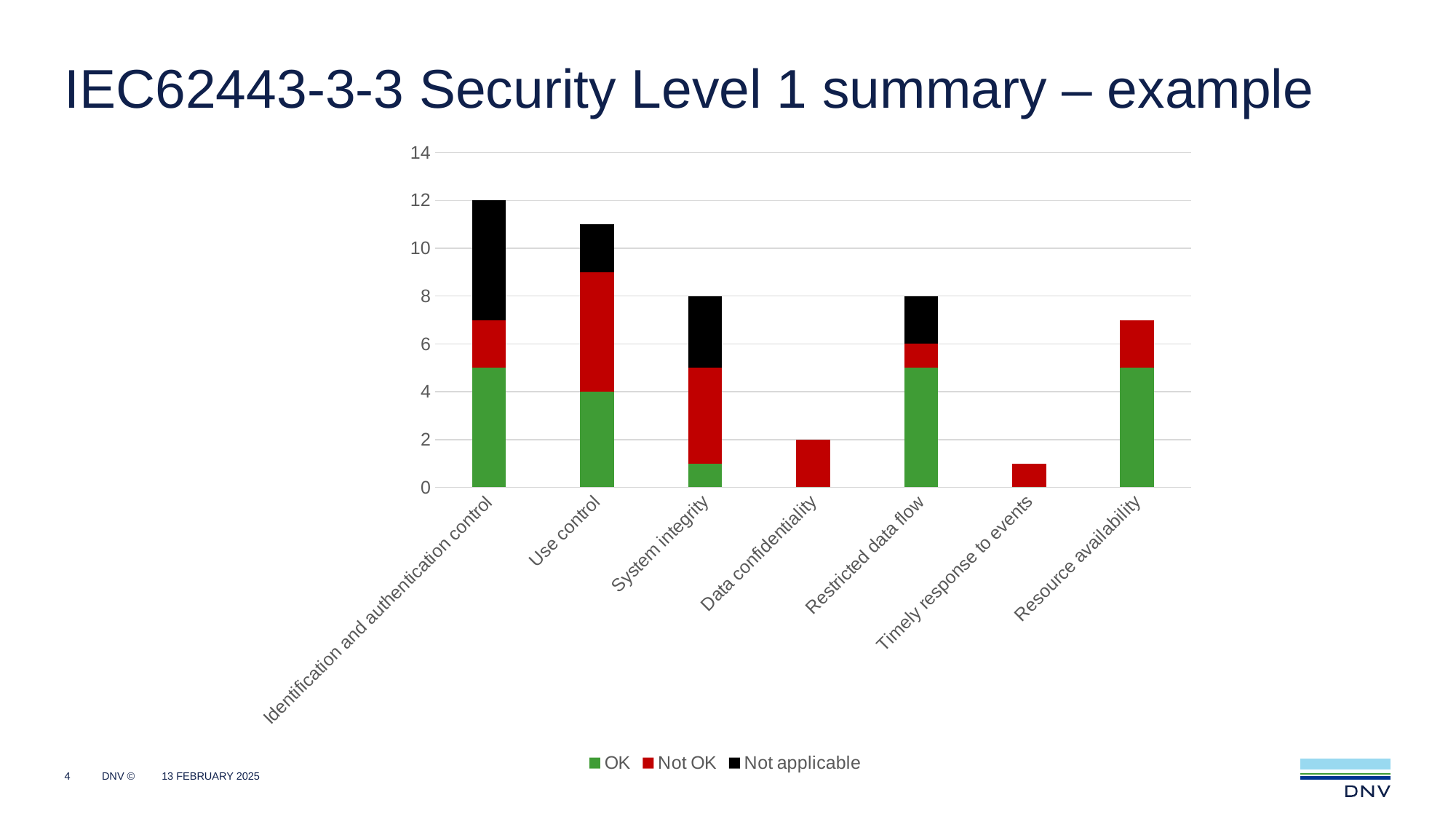
What is the total height of the stacked bar for Identification and authentication control? 12 How many categories are shown on the x axis of the chart? 7 What is the OK value for Use control? 4 How many series does the legend list? 3 Which has the taller stacked bar, Use control or Resource availability? Use control Which category has the shortest stacked bar overall? Timely response to events Is the total for Use control greater or less than 10? greater What is the total height of the stacked bar for System integrity? 8 Which category has the tallest stacked bar overall? Identification and authentication control What kind of chart is shown on the slide? Stacked bar chart Which colour represents the Not applicable series in the legend? Black What is the total height of the stacked bar for Data confidentiality? 2